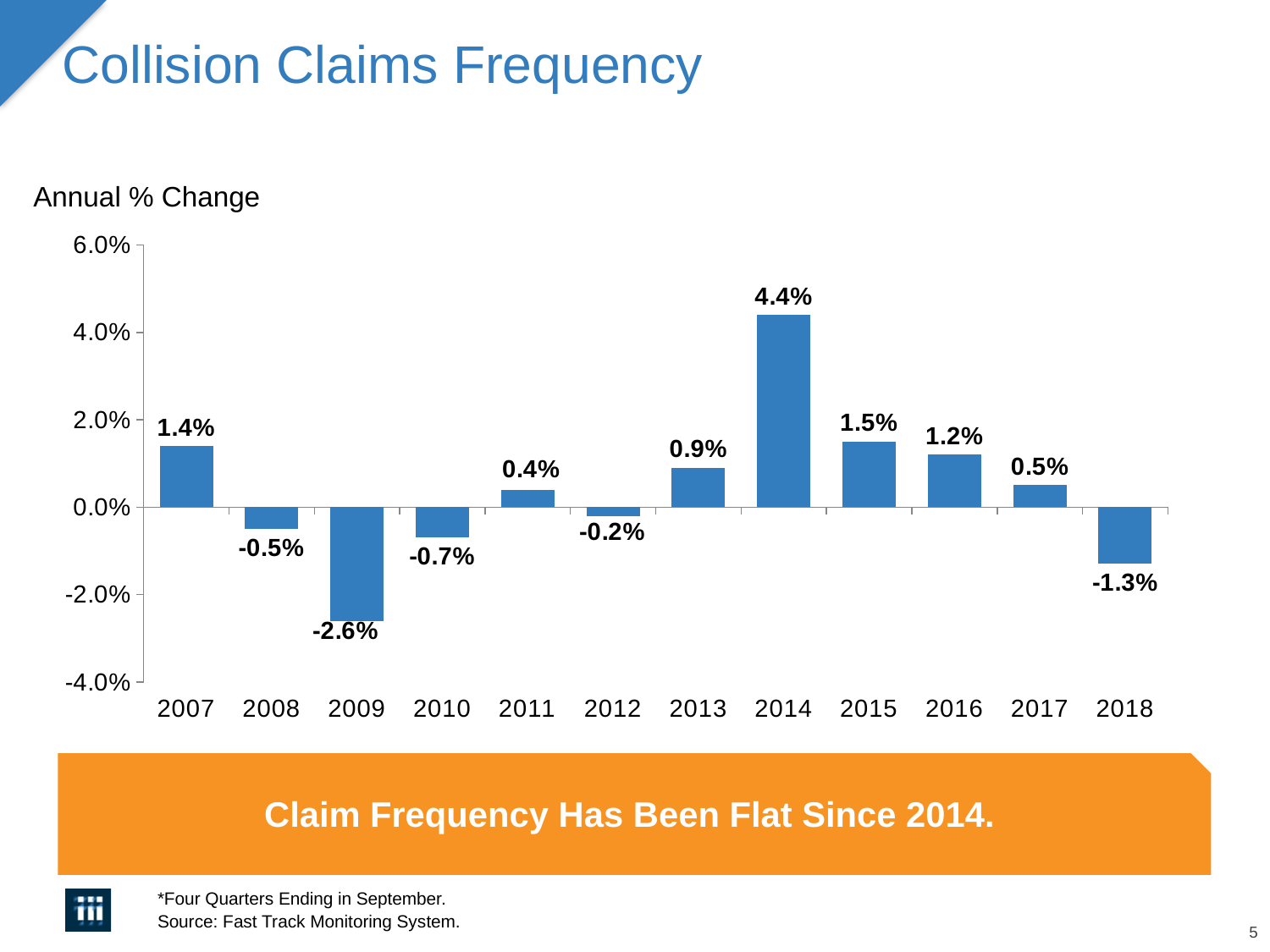
Which year has the lowest annual % change in collision claims frequency? 2009 What is the annual % change in collision claims frequency for 2009? -2.6% Which year has the highest annual % change in collision claims frequency? 2014 Which year has a larger annual % change, 2015 or 2016? 2015 Is the value for 2014 greater or less than 4.0%? greater Do the values rise or fall from 2015 to 2018? Fall How many years are shown on the x axis of the chart? 12 What is the annual % change in collision claims frequency for 2018? -1.3% What is the title of the slide containing the chart? Collision Claims Frequency What is the difference between the annual % change in 2014 and in 2015? 2.9% What kind of chart is shown on the slide? Bar chart What is the annual % change in collision claims frequency for 2014? 4.4%